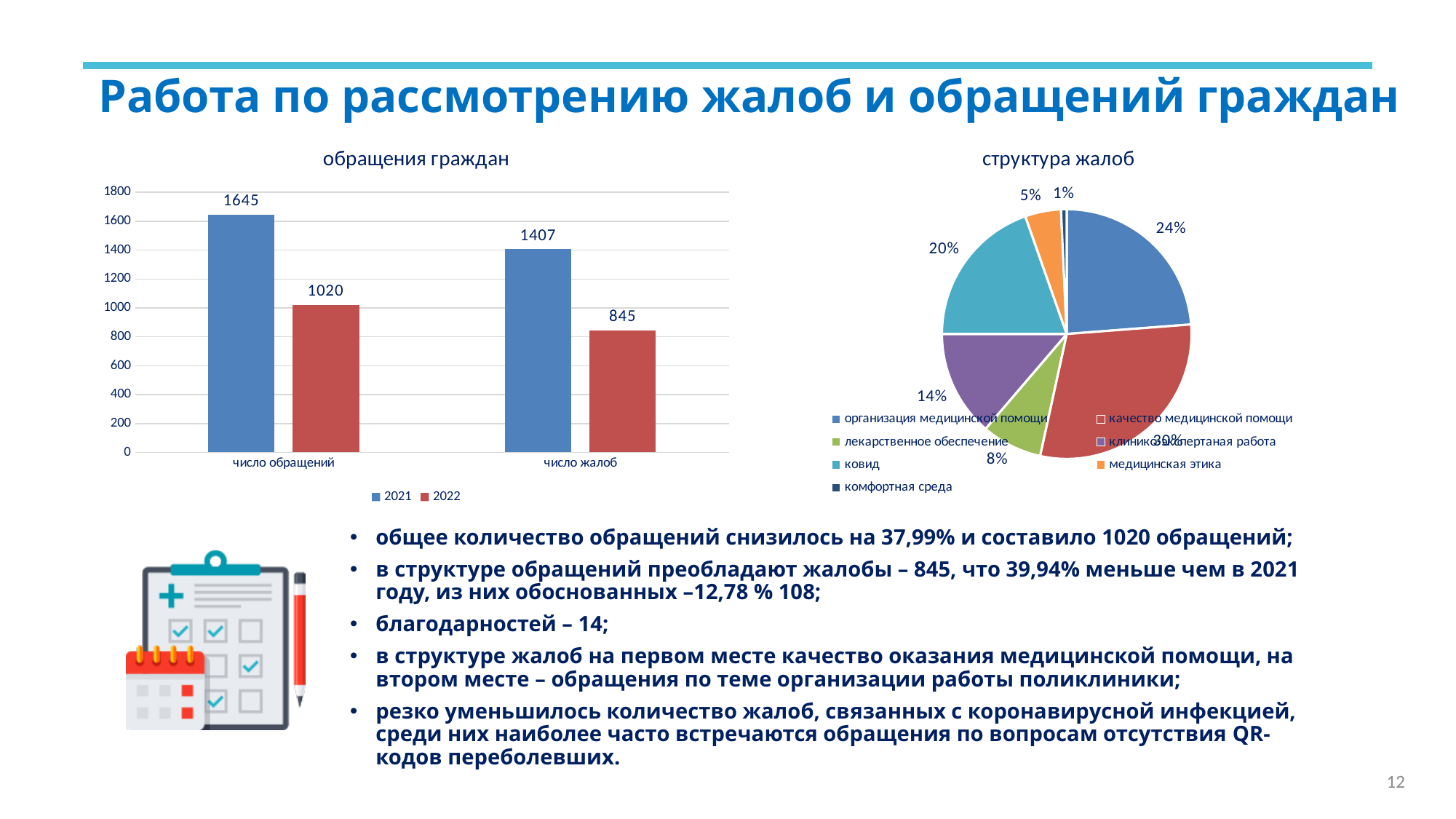
How many series does the legend of the bar chart 'обращения граждан' list? 2 In the pie chart 'структура жалоб', what share does 'организация медицинской помощи' have? 24% In the pie chart 'структура жалоб', what share does 'ковид' have? 20% In the bar chart 'обращения граждан', which bar has the highest value? число обращений, 2021 In the bar chart 'обращения граждан', which is larger: 'число жалоб' in 2021 or 'число обращений' in 2022? число жалоб in 2021 In the bar chart 'обращения граждан', what is the difference between the 2021 and 2022 values for 'число обращений'? 625 In the bar chart 'обращения граждан', what is the value for 'число жалоб' in 2022? 845 What kind of chart is 'обращения граждан'? bar chart In the pie chart 'структура жалоб', which category has the smallest slice? комфортная среда How many categories does the legend of the pie chart 'структура жалоб' list? 7 In the bar chart 'обращения граждан', what is the value for 'число обращений' in 2021? 1645 In the bar chart 'обращения граждан', what is the difference between the 2021 and 2022 values for 'число жалоб'? 562